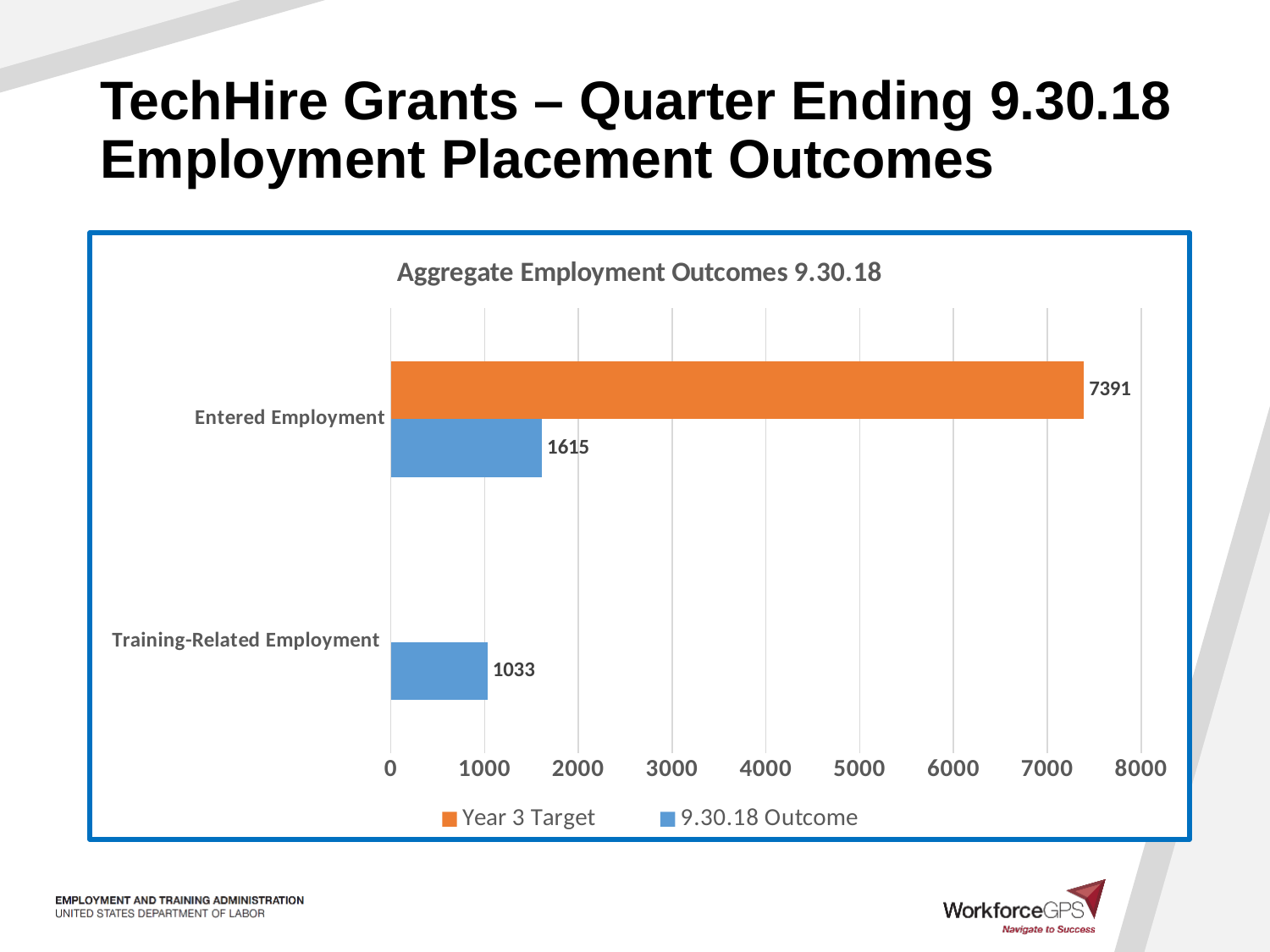
Is the Year 3 Target for Entered Employment greater or less than 7000? greater Which is larger: the Year 3 Target for Entered Employment or the 9.30.18 Outcome for Entered Employment? Year 3 Target What is the 9.30.18 Outcome value for Training-Related Employment? 1033 What is the difference between the 9.30.18 Outcome for Entered Employment and for Training-Related Employment? 582 Which category has the lower 9.30.18 Outcome value? Training-Related Employment What is the difference between the Year 3 Target and the 9.30.18 Outcome for Entered Employment? 5776 What is the 9.30.18 Outcome value for Entered Employment? 1615 What kind of chart is shown on the slide? Bar chart Which category has the higher 9.30.18 Outcome value? Entered Employment How many series does the legend list? 2 What is the Year 3 Target value for Entered Employment? 7391 What is the title of the chart? Aggregate Employment Outcomes 9.30.18